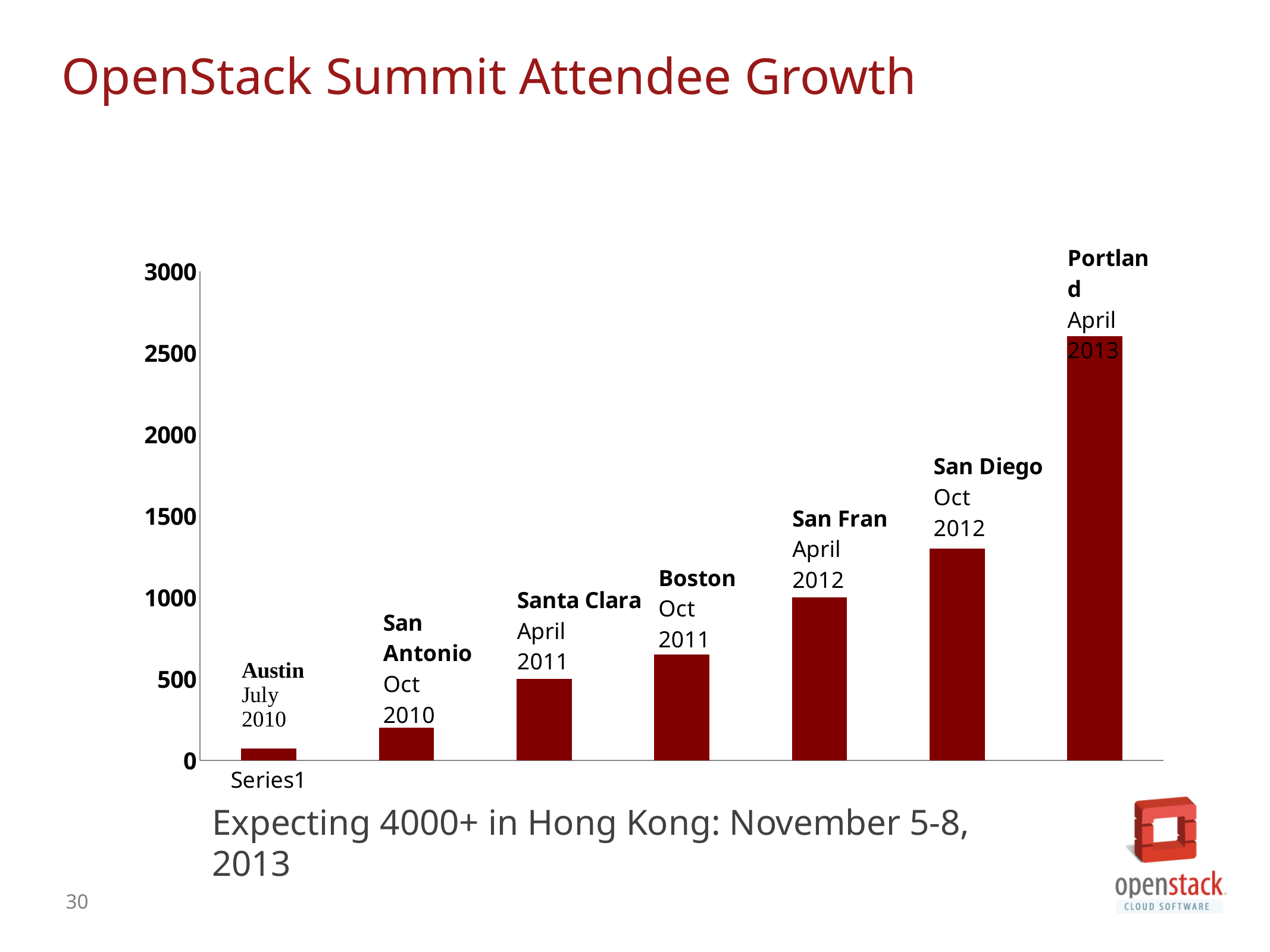
Do attendee numbers rise or fall from Austin July 2010 to Portland April 2013? rise Is the value for Boston Oct 2011 greater or less than 500? greater Is the value for Portland April 2013 greater or less than 2500? greater Which summit has the highest attendee count in the chart? Portland April 2013 How many summits (bars) are plotted in the chart? 7 What label appears under the x axis of the chart? Series1 Is the value for San Diego Oct 2012 greater or less than 1500? less What kind of chart is shown on the slide? bar chart Which summit had more attendees, San Diego Oct 2012 or Boston Oct 2011? San Diego Oct 2012 What is the title of the chart on the slide? OpenStack Summit Attendee Growth Which summit has the lowest attendee count in the chart? Austin July 2010